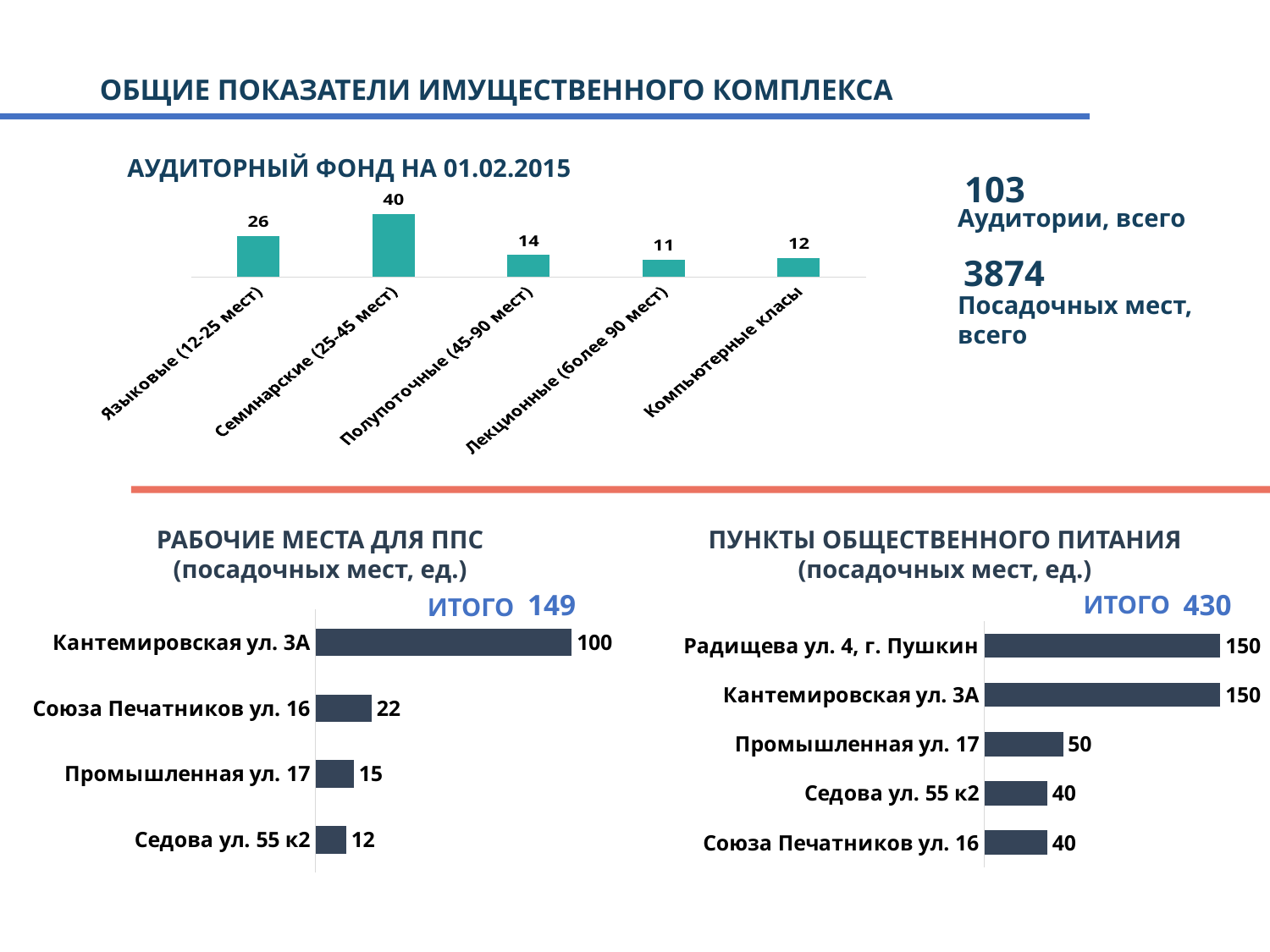
In the chart 'АУДИТОРНЫЙ ФОНД НА 01.02.2015', what is the difference between 'Языковые (12-25 мест)' and 'Полупоточные (45-90 мест)'? 12 In the chart 'РАБОЧИЕ МЕСТА ДЛЯ ППС', what is the value for 'Союза Печатников ул. 16'? 22 In the chart 'РАБОЧИЕ МЕСТА ДЛЯ ППС', which category has the highest value? Кантемировская ул. 3А How many categories are shown in the chart 'ПУНКТЫ ОБЩЕСТВЕННОГО ПИТАНИЯ'? 5 What total ('ИТОГО') is shown for the chart 'РАБОЧИЕ МЕСТА ДЛЯ ППС'? 149 In the chart 'ПУНКТЫ ОБЩЕСТВЕННОГО ПИТАНИЯ', what is the value for 'Промышленная ул. 17'? 50 How many categories are shown in the chart 'АУДИТОРНЫЙ ФОНД НА 01.02.2015'? 5 In the chart 'АУДИТОРНЫЙ ФОНД НА 01.02.2015', which category has the lowest value? Лекционные (более 90 мест) In the chart 'РАБОЧИЕ МЕСТА ДЛЯ ППС', what is the difference between 'Кантемировская ул. 3А' and 'Седова ул. 55 к2'? 88 What type of chart is 'АУДИТОРНЫЙ ФОНД НА 01.02.2015'? Bar chart In the chart 'АУДИТОРНЫЙ ФОНД НА 01.02.2015', what is the value for 'Семинарские (25-45 мест)'? 40 In the chart 'ПУНКТЫ ОБЩЕСТВЕННОГО ПИТАНИЯ', which is larger: 'Промышленная ул. 17' or 'Седова ул. 55 к2'? Промышленная ул. 17